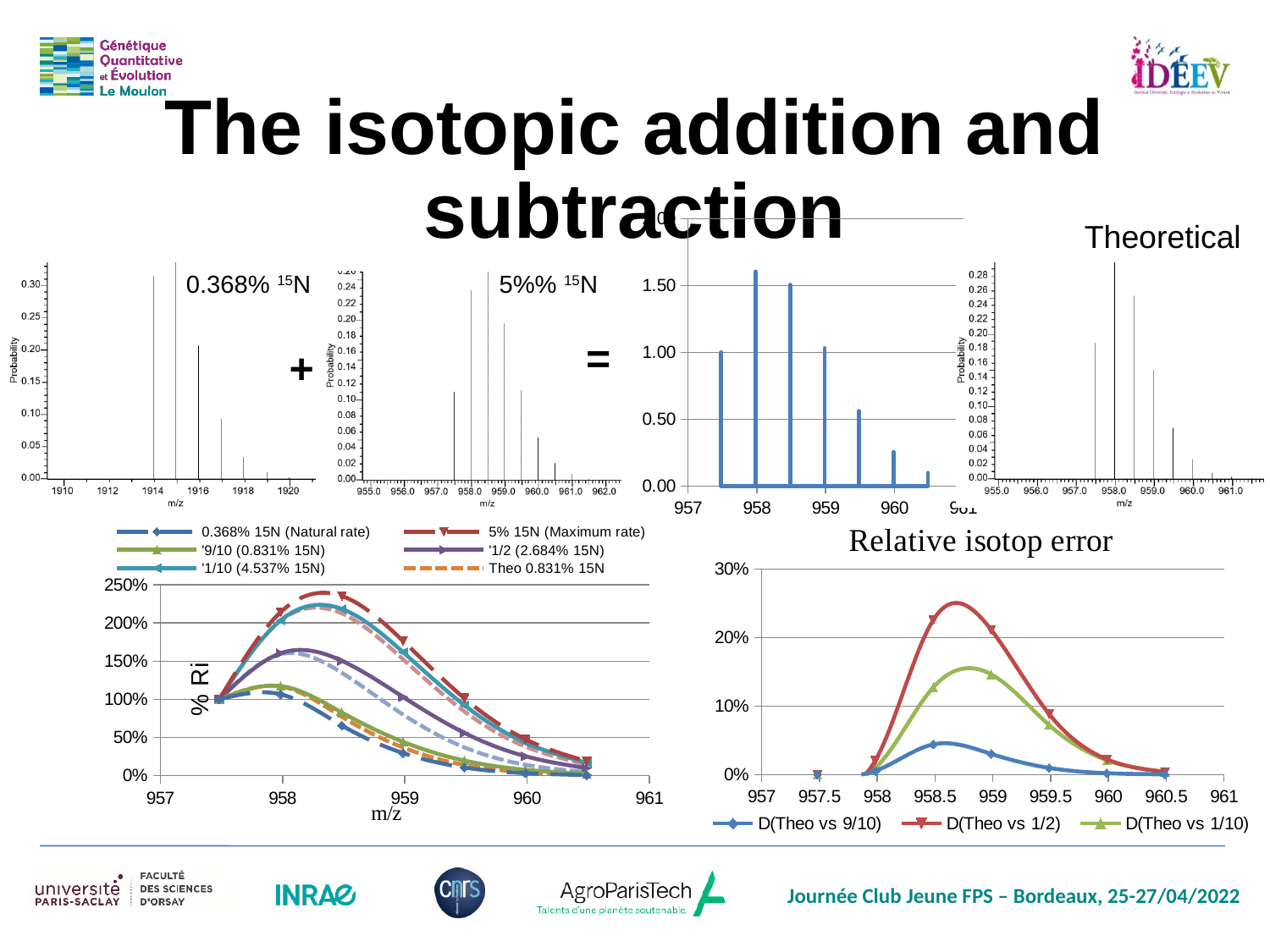
In the bottom-right chart titled 'Relative isotop error', which series has the lowest peak? D(Theo vs 9/10) In the bar chart in the top row with the y-axis running from 0.00 to 1.50, how many bars are plotted? 7 In the bottom-left chart with the y-axis labelled '% Ri', is the peak value of the '0.368% 15N (Natural rate)' series greater or less than 150%? less In the bottom-left chart with the y-axis labelled '% Ri', how many series does the legend list? 6 In the bottom-right chart titled 'Relative isotop error', is the peak value of D(Theo vs 9/10) greater or less than 10%? less In the bottom-right chart titled 'Relative isotop error', which series reaches the highest peak? D(Theo vs 1/2) In the bottom-right chart titled 'Relative isotop error', how many series does the legend list? 3 In the bar chart in the top row with the y-axis running from 0.00 to 1.50, is the bar at 960 greater or less than 0.50? less What kind of chart is the bottom-right chart titled 'Relative isotop error'? line chart What is the x-axis label of the bottom-left chart with the y-axis labelled '% Ri'? m/z